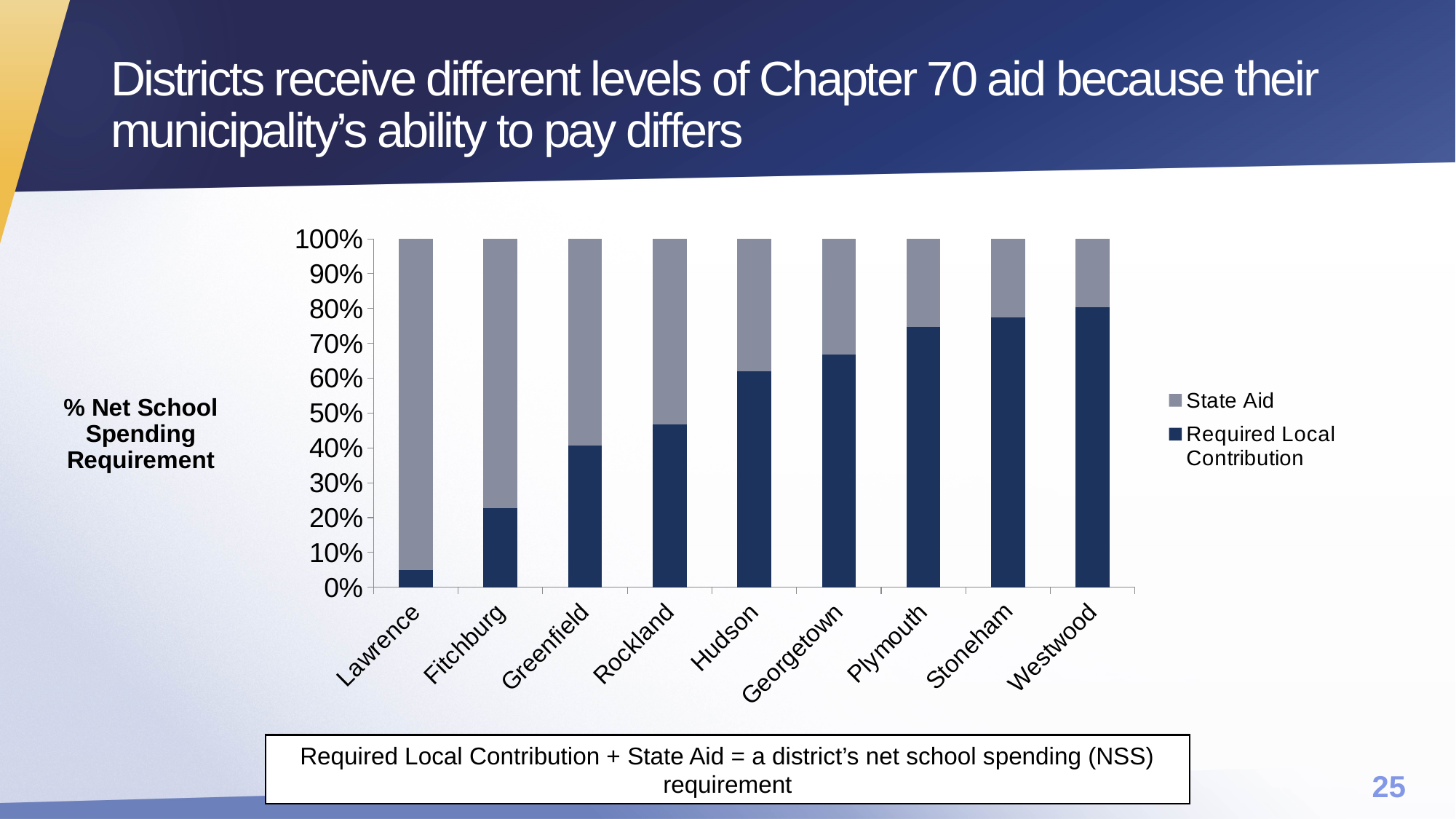
Does the Required Local Contribution share rise or fall moving from Lawrence to Westwood along the x axis? Rise Is the Required Local Contribution for Hudson greater or less than 60%? greater Which district has the highest Required Local Contribution share? Westwood What does each stacked bar total? 100% Is the Required Local Contribution for Rockland greater or less than 50%? less Is the Required Local Contribution for Lawrence greater or less than 10%? less What kind of chart is shown on the slide? Stacked bar chart Which district receives the largest share of State Aid? Lawrence How many districts are shown on the x axis of the chart? 9 Which district has the lowest Required Local Contribution share? Lawrence Which district has a larger Required Local Contribution share, Fitchburg or Plymouth? Plymouth How many series does the chart's legend list? 2